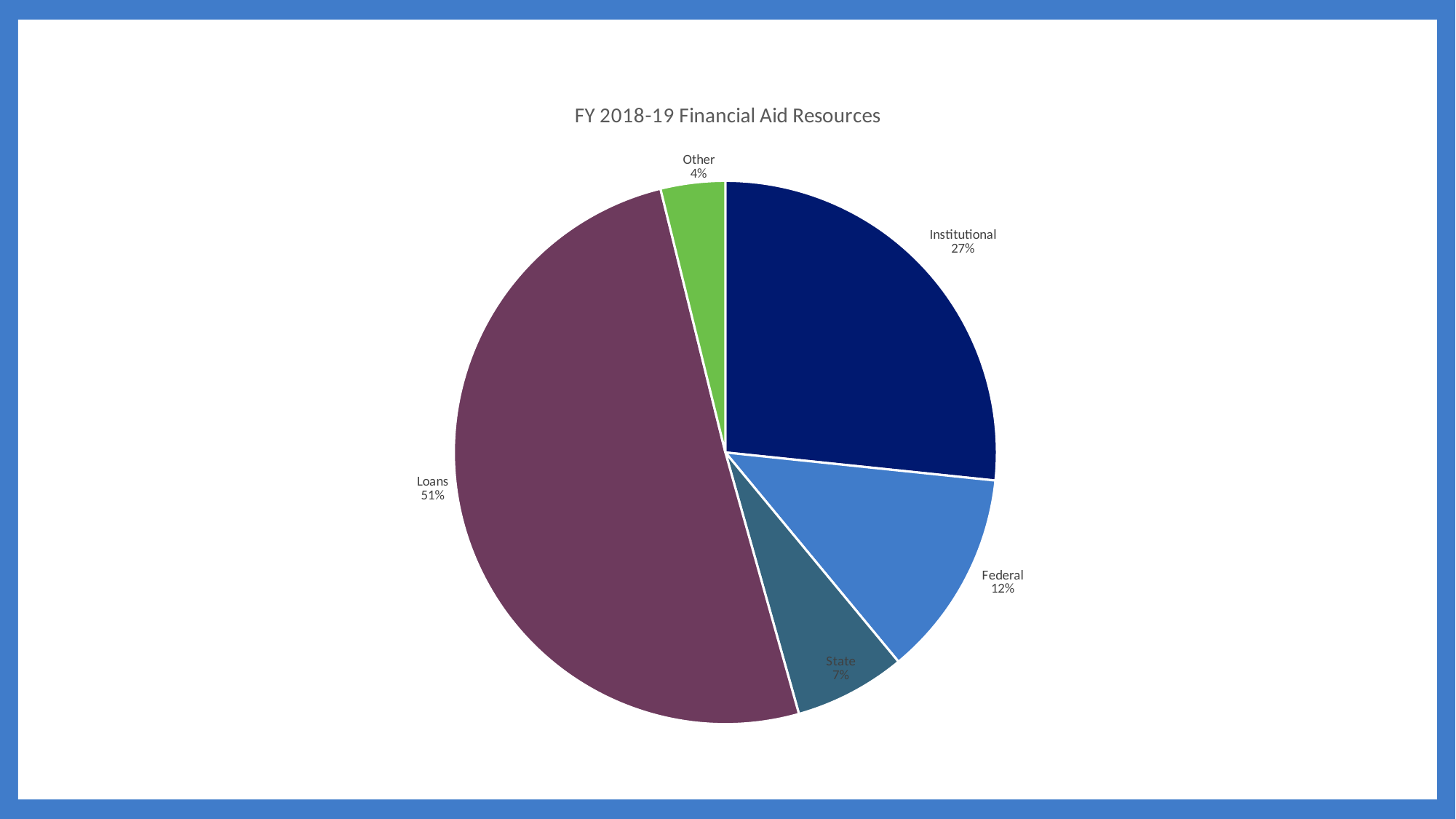
How many slices does the pie chart have? 5 Which category has the smallest slice? Other What is the title of the chart? FY 2018-19 Financial Aid Resources Which category has the largest slice? Loans What is the difference in percentage points between Loans and Institutional? 24 What share of the pie is Institutional? 27% What share of the pie is Other? 4% What share of the pie is State? 7% Which is larger, Federal or State? Federal What kind of chart is shown on the slide? pie chart